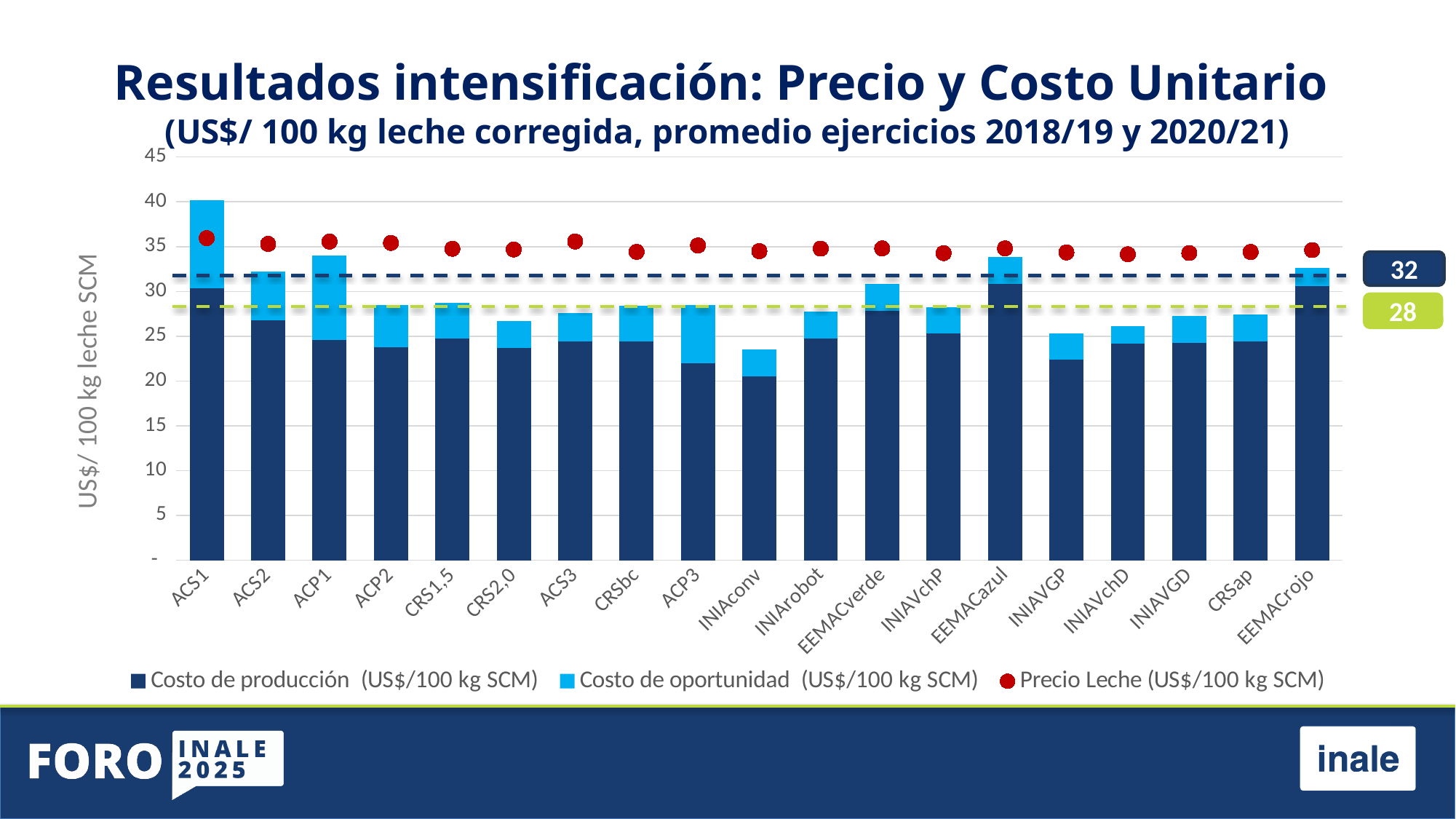
Which has the larger total bar, ACS1 or ACS2? ACS1 Is the total bar for INIAconv greater or less than 25? less Which category has the highest total bar (production cost plus opportunity cost)? ACS1 What two values are marked by the dashed horizontal reference lines? 32 and 28 How many categories (farm systems) are shown on the x axis? 19 Which category has the lowest total bar (production cost plus opportunity cost)? INIAconv Is the total bar for ACS1 greater or less than 35? greater Is the Costo de producción value for INIAconv greater or less than 25? less What kind of chart is shown on the slide? Stacked bar chart with a dot series Which series is represented by the red dots? Precio Leche (US$/100 kg SCM) How many series does the legend list? 3